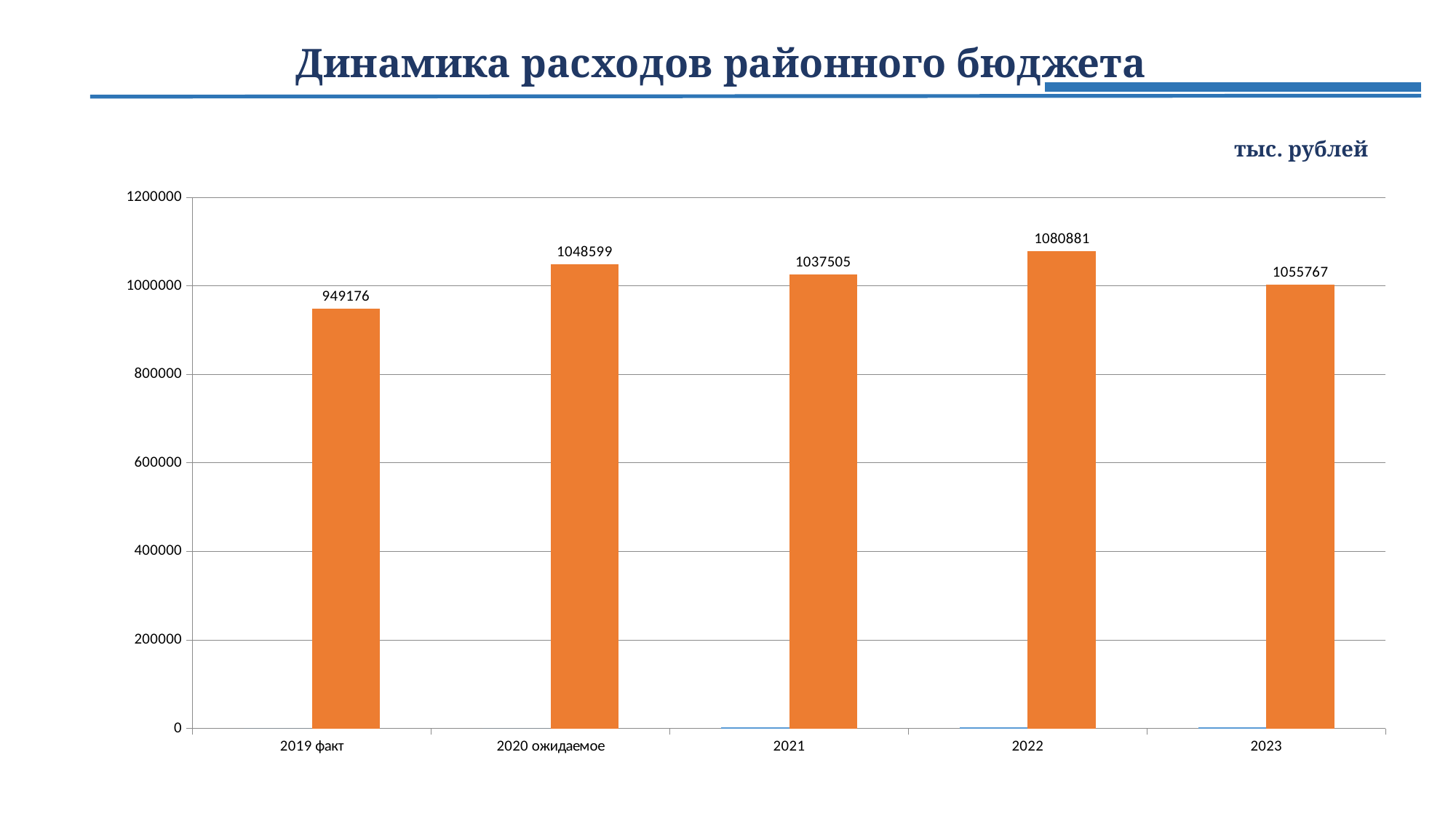
What is the value for 2022? 1080881 Which category has the highest value? 2022 Which is larger, the value for 2020 ожидаемое or the value for 2021? 2020 ожидаемое What is the difference between the values for 2022 and 2019 факт? 131705 What kind of chart is shown on the slide? bar chart What is the value for 2019 факт? 949176 What is the value for 2023? 1055767 Which category has the lowest value? 2019 факт What is the title of the chart? Динамика расходов районного бюджета What is the value for 2020 ожидаемое? 1048599 Is the value for 2019 факт greater or less than 1000000? less How many categories are shown on the x axis? 5